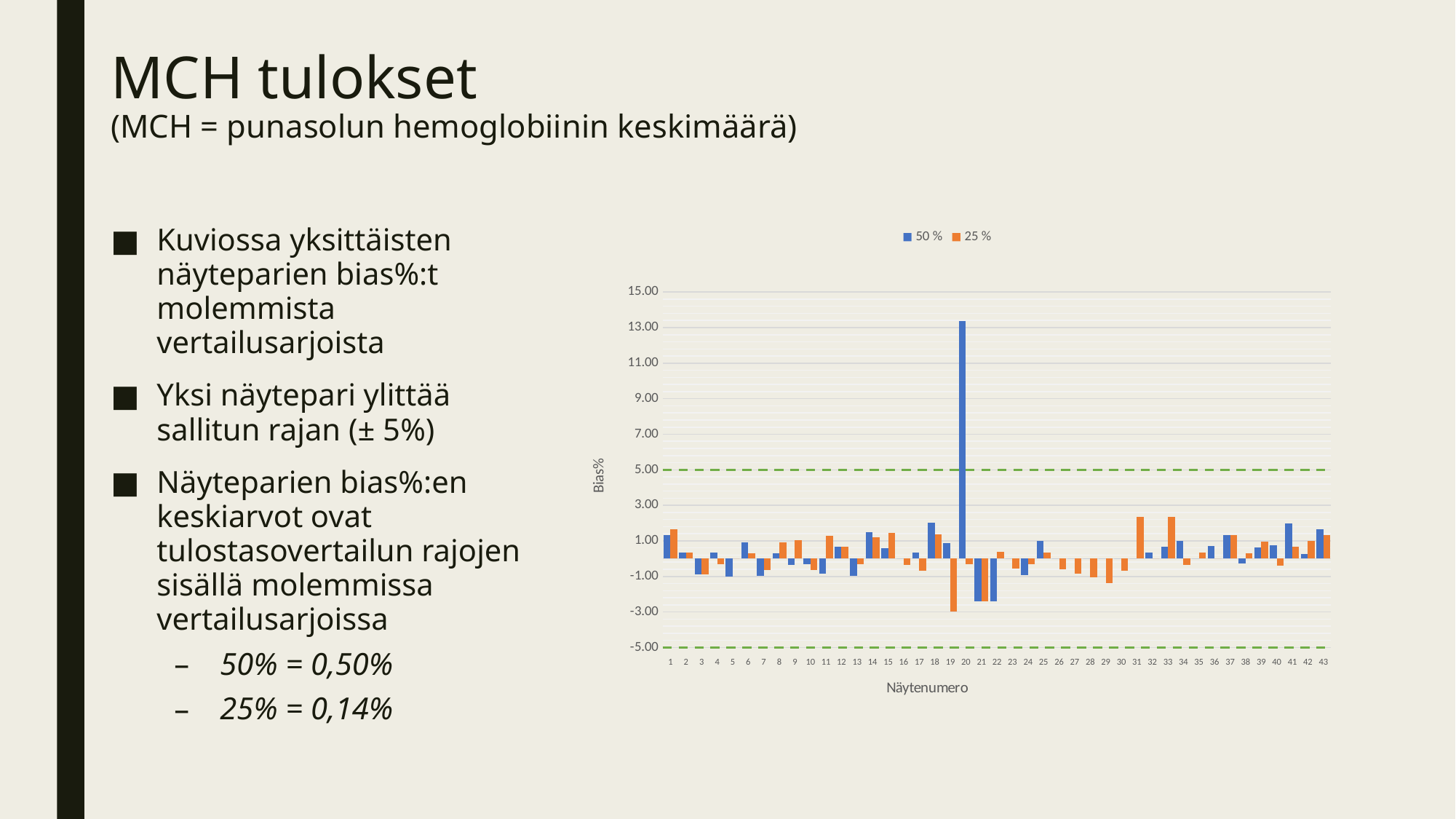
Which sample number has the highest bias% value for the 50 % series? 20 How many series does the chart legend list? 2 What kind of chart is shown on the slide? Bar chart Is the 50 % series value for sample 22 greater or less than -1.00? less Is the 25 % series value for sample 31 greater or less than 1.00? greater Which sample number has the lowest bias% value for the 25 % series? 19 What is the label of the y axis of the chart? Bias% Is the 25 % series value for sample 19 greater or less than -1.00? less Which is larger for the 50 % series: the value for sample 20 or the value for sample 1? Sample 20 What are the two series named in the chart legend? 50 % and 25 % How many sample numbers (Näytenumero) are plotted along the x axis? 43